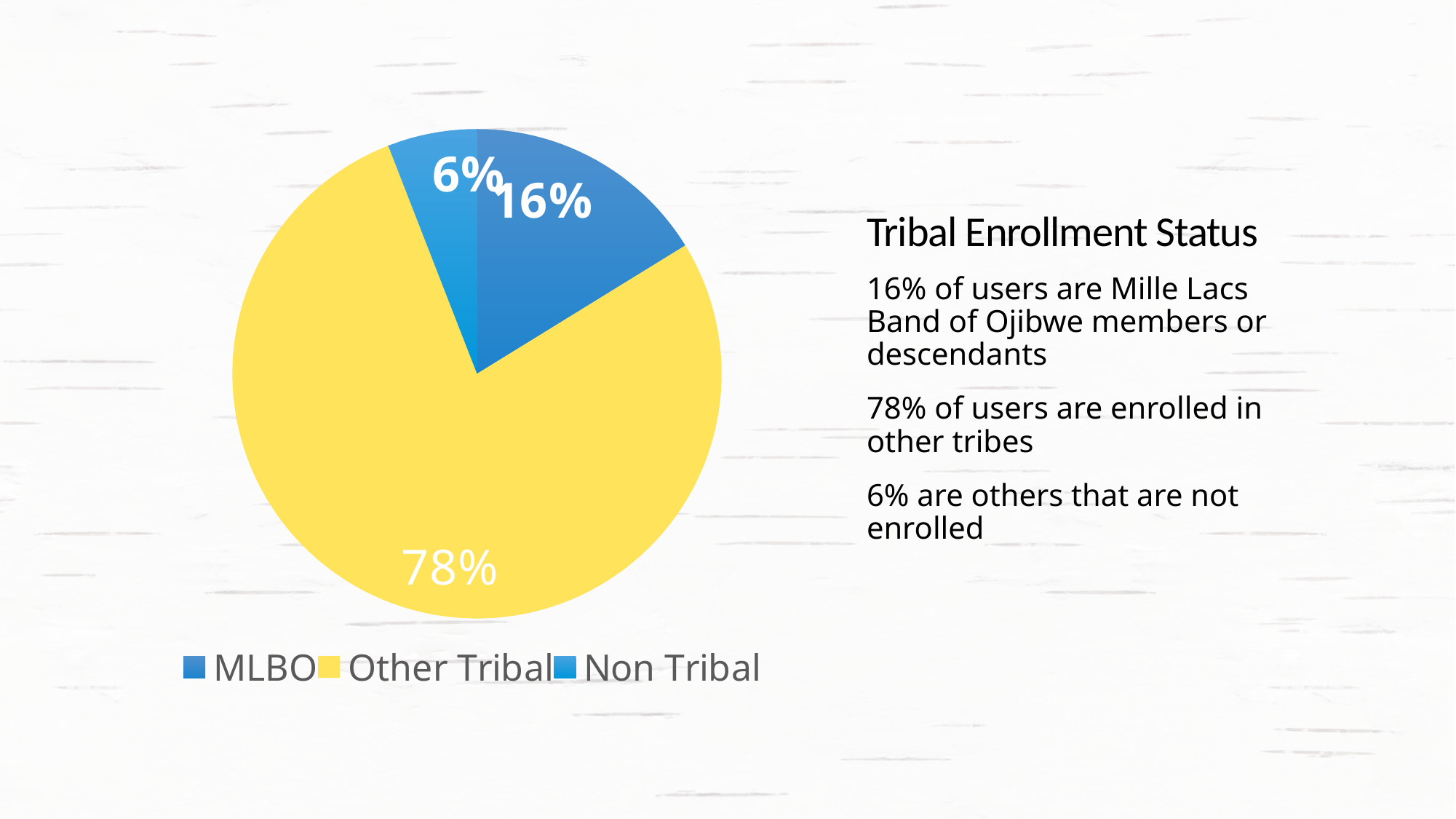
What share of the pie does Non Tribal represent? 6% What share of the pie does MLBO represent? 16% What is the difference in percentage points between MLBO and Non Tribal? 10 What colour is the Other Tribal slice? yellow Which category has the largest slice of the pie? Other Tribal How many categories does the pie chart have? 3 Which is larger, the MLBO slice or the Non Tribal slice? MLBO What are the three legend entries of the pie chart? MLBO, Other Tribal, Non Tribal Which category has the smallest slice of the pie? Non Tribal What is the difference in percentage points between Other Tribal and MLBO? 62 What share of the pie does Other Tribal represent? 78% What kind of chart is shown on the slide? pie chart